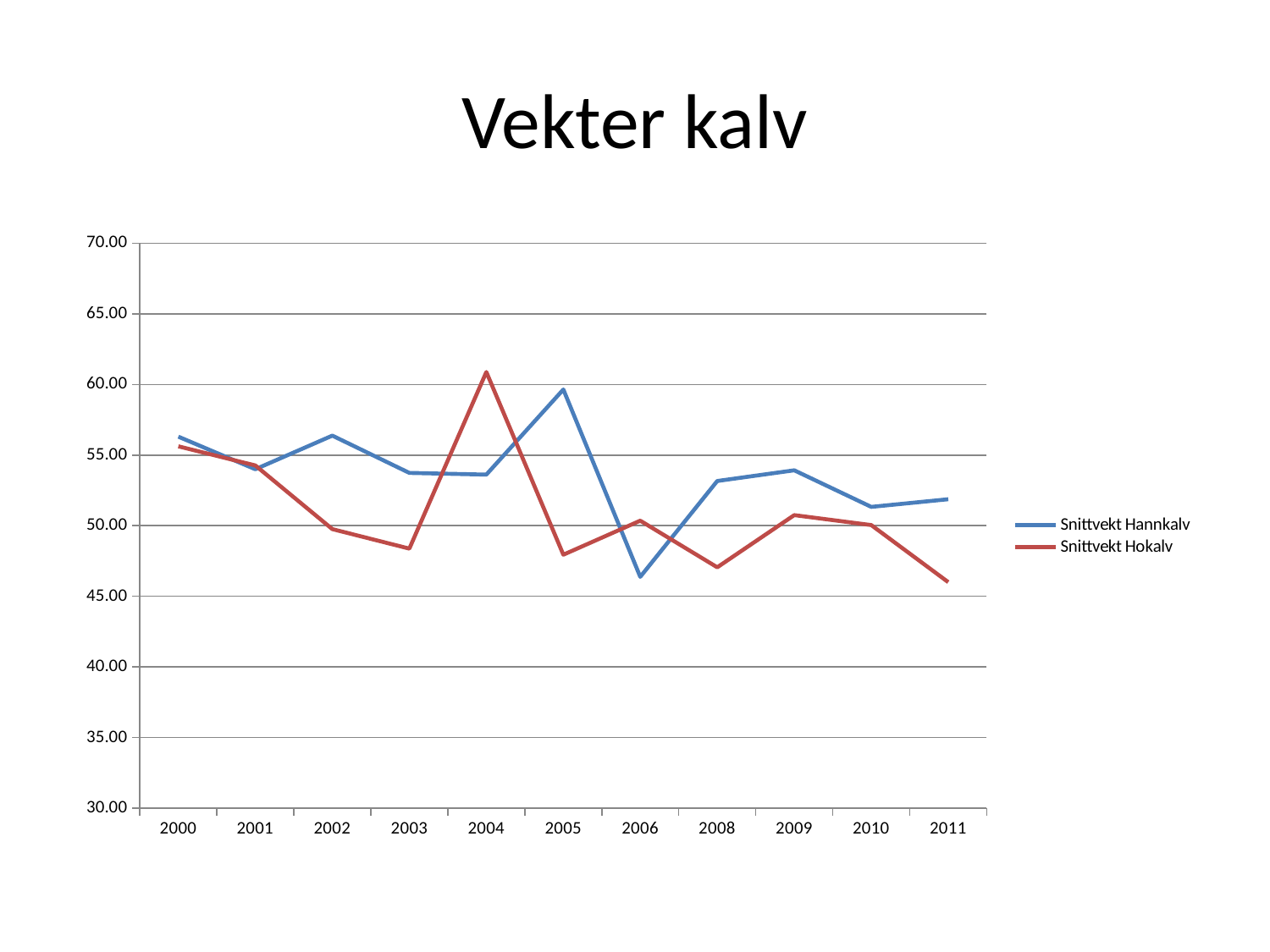
In which year is Snittvekt Hannkalv highest? 2005 How many years are shown on the x axis? 11 In which year is Snittvekt Hokalv highest? 2004 In which year is Snittvekt Hannkalv lowest? 2006 How many series does the legend list? 2 Does Snittvekt Hokalv rise or fall from 2009 to 2011? fall What kind of chart is shown on the slide? line chart Is the value for Snittvekt Hannkalv in 2006 greater or less than 50.00? less Which series is drawn in red? Snittvekt Hokalv In 2004, which series has the higher value, Snittvekt Hannkalv or Snittvekt Hokalv? Snittvekt Hokalv What is the title of the slide? Vekter kalv In 2005, which series has the higher value, Snittvekt Hannkalv or Snittvekt Hokalv? Snittvekt Hannkalv